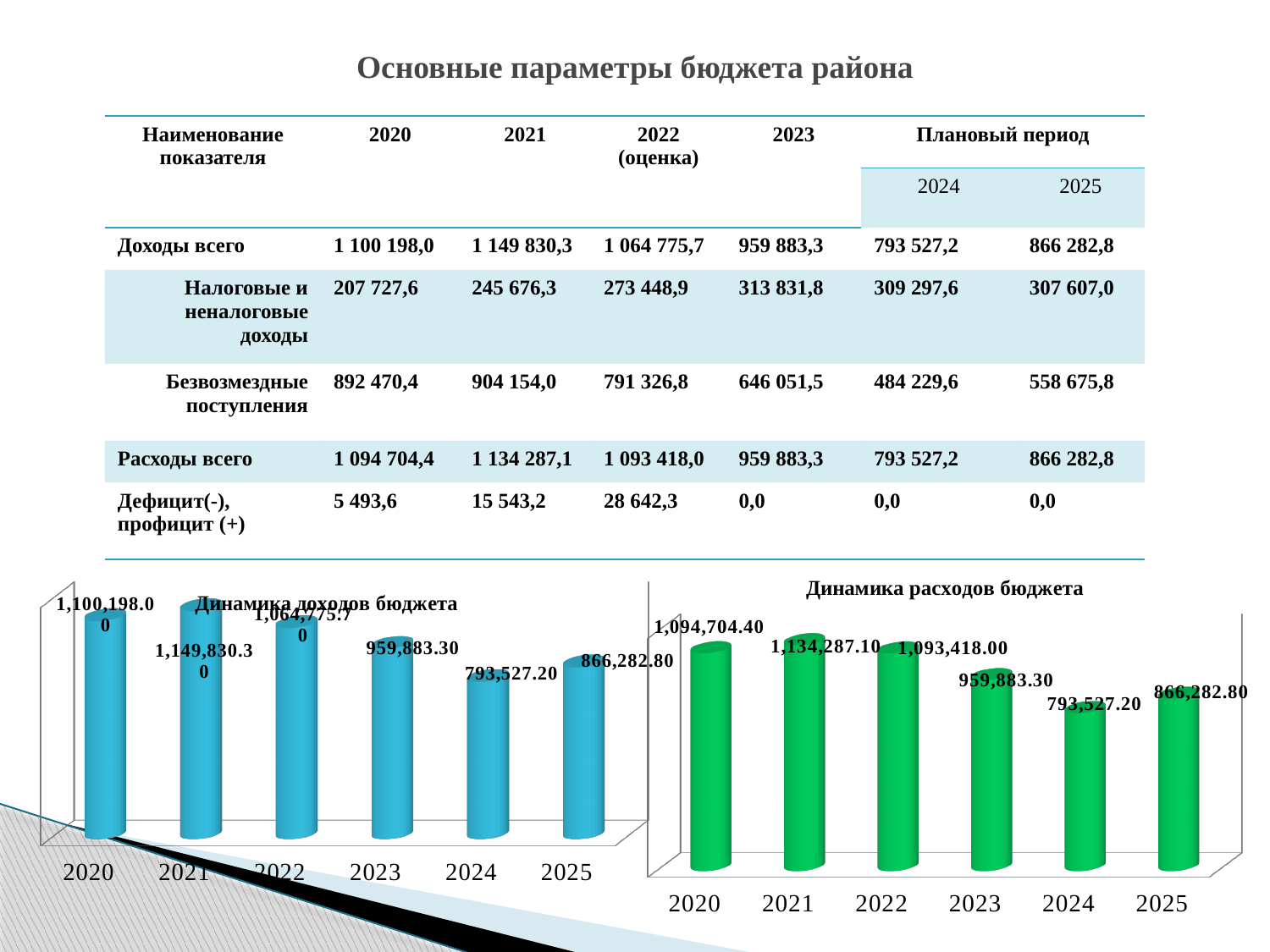
In the chart titled "Динамика расходов бюджета", do the values rise or fall from 2021 to 2024? Fall How many years are shown on the x axis of the chart titled "Динамика расходов бюджета"? 6 In the chart titled "Динамика расходов бюджета", what is the value for 2024? 793,527.20 In the chart titled "Динамика расходов бюджета", which year has the highest value? 2021 In the chart titled "Динамика доходов бюджета", which year has the highest value? 2021 In the chart titled "Динамика доходов бюджета", which year has the lowest value? 2024 In the chart titled "Динамика доходов бюджета", what is the value for 2023? 959,883.30 What kind of chart is the chart titled "Динамика доходов бюджета"? Bar chart In the chart titled "Динамика расходов бюджета", what is the value for 2021? 1,134,287.10 In the chart titled "Динамика расходов бюджета", which is larger, the value for 2023 or the value for 2025? 2023 In the chart titled "Динамика расходов бюджета", what is the difference between the values for 2025 and 2024? 72,755.60 In the chart titled "Динамика расходов бюджета", which year has the lowest value? 2024